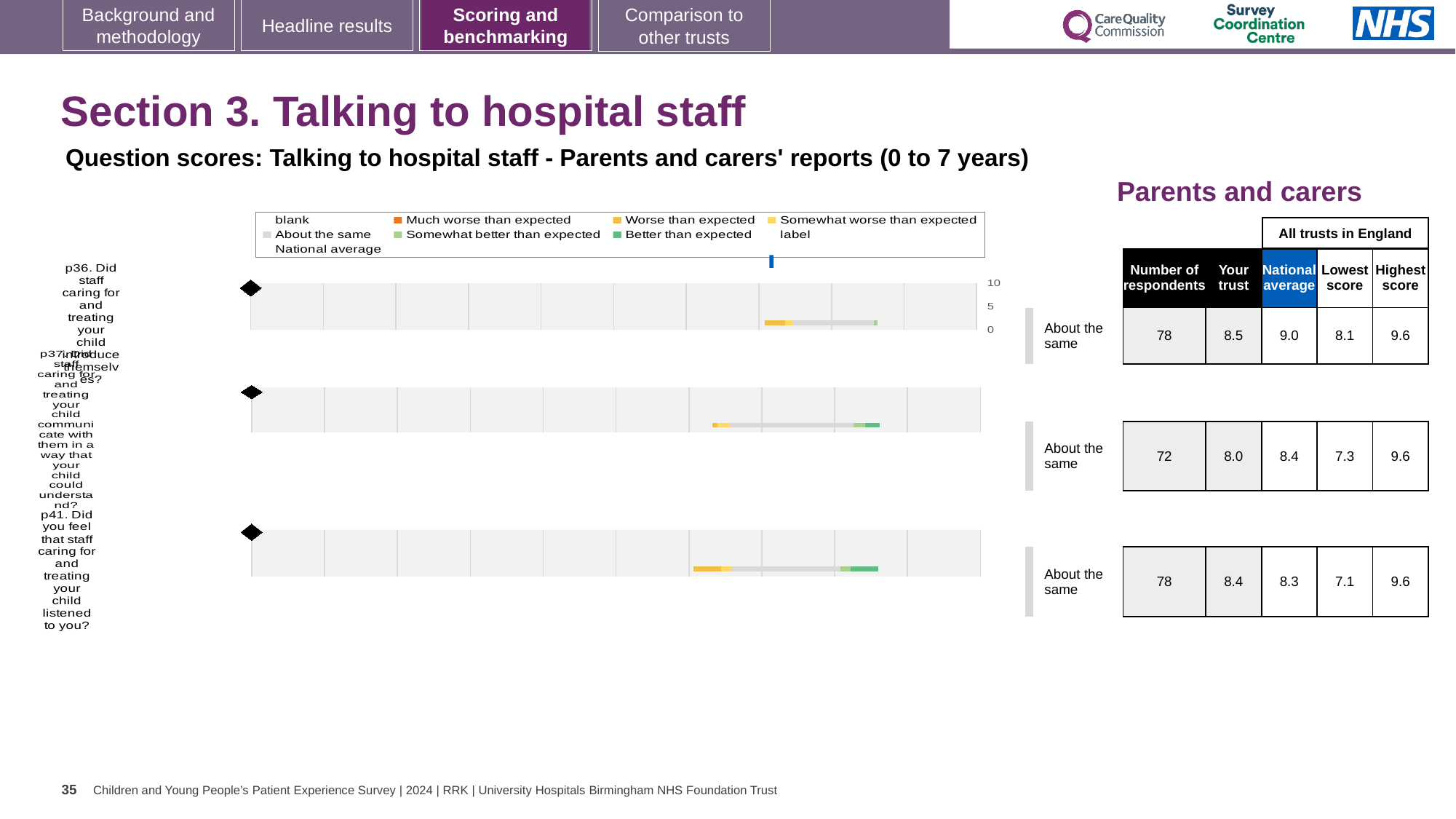
Is the 'Your trust' score for p37 greater or less than 5 on the chart axis? greater Which question has the lowest 'Lowest score' across all trusts in England? p41 How many respondents answered p37? 72 For p41, which is larger: the 'Your trust' score or the national average? Your trust What is the difference between the national average and the 'Your trust' score for p36? 0.5 What is the national average score for p37 (Did staff communicate with them in a way that your child could understand?)? 8.4 Which question has the highest 'Your trust' score? p36 What is the 'Your trust' score for p36 (Did staff caring for and treating your child introduce themselves?)? 8.5 What benchmark category is shown for all three questions? About the same How many questions are plotted on this slide? 3 What is the highest score across all trusts in England for p41 (Did you feel that staff caring for and treating your child listened to you?)? 9.6 What kind of chart is used to show the question scores? Bar chart